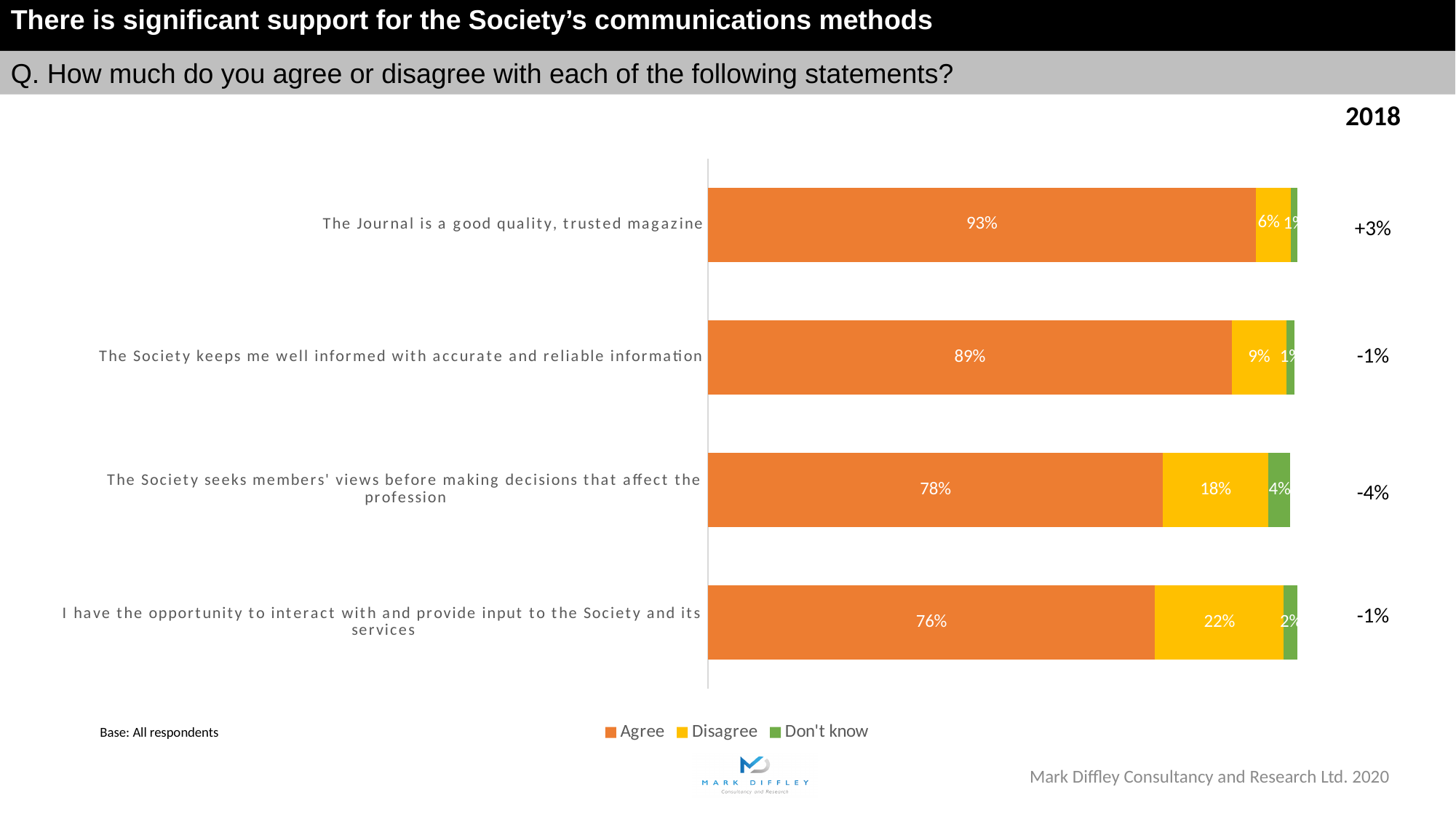
What kind of chart is shown on the slide? Stacked bar chart How many statements are shown in the chart? 4 What is the Don't know percentage for the statement 'The Society seeks members' views before making decisions that affect the profession'? 4% What is the change versus 2018 shown for 'The Society seeks members' views before making decisions that affect the profession'? -4% Which statement has the lowest Agree percentage? I have the opportunity to interact with and provide input to the Society and its services Which has a larger Disagree percentage: 'The Society seeks members' views before making decisions that affect the profession' or 'The Society keeps me well informed with accurate and reliable information'? The Society seeks members' views before making decisions that affect the profession What percentage of respondents agree that the Journal is a good quality, trusted magazine? 93% What is the difference between the Agree percentage for 'The Journal is a good quality, trusted magazine' and for 'I have the opportunity to interact with and provide input to the Society and its services'? 17% What percentage agree that the Society keeps them well informed with accurate and reliable information? 89% What percentage of respondents disagree that they have the opportunity to interact with and provide input to the Society and its services? 22% How many series does the legend list? 3 Which statement has the highest Agree percentage? The Journal is a good quality, trusted magazine